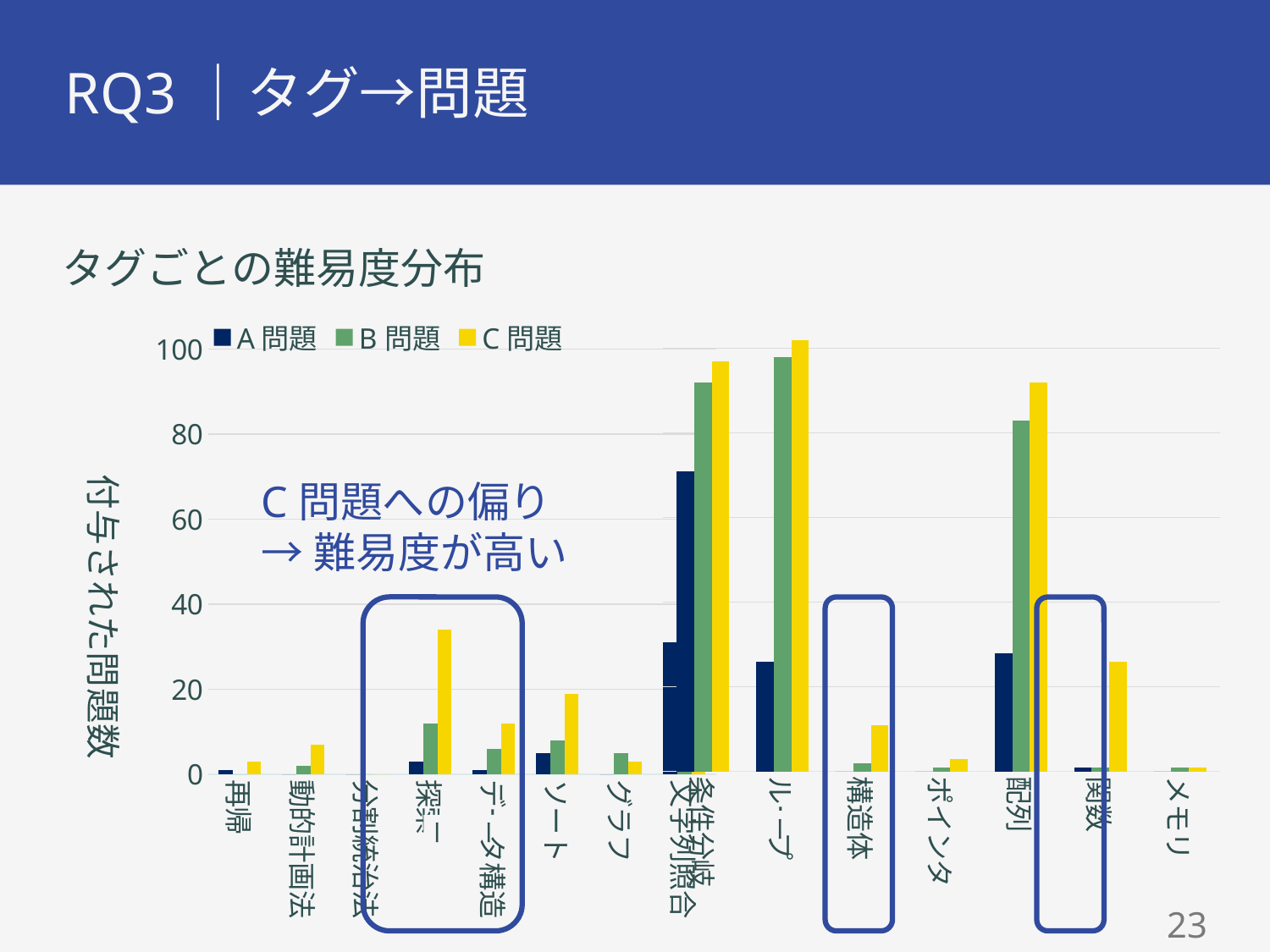
What kind of chart is shown on the slide? bar chart Is the C 問題 value for 探索 greater or less than 20? greater For 配列, which is larger: the B 問題 value or the C 問題 value? C 問題 Is the C 問題 value for 関数 greater or less than 40? less What colour represents C 問題 in the legend? yellow Which category has the highest C 問題 value? ループ Is the B 問題 value for ループ greater or less than 80? greater How many series does the legend list? 3